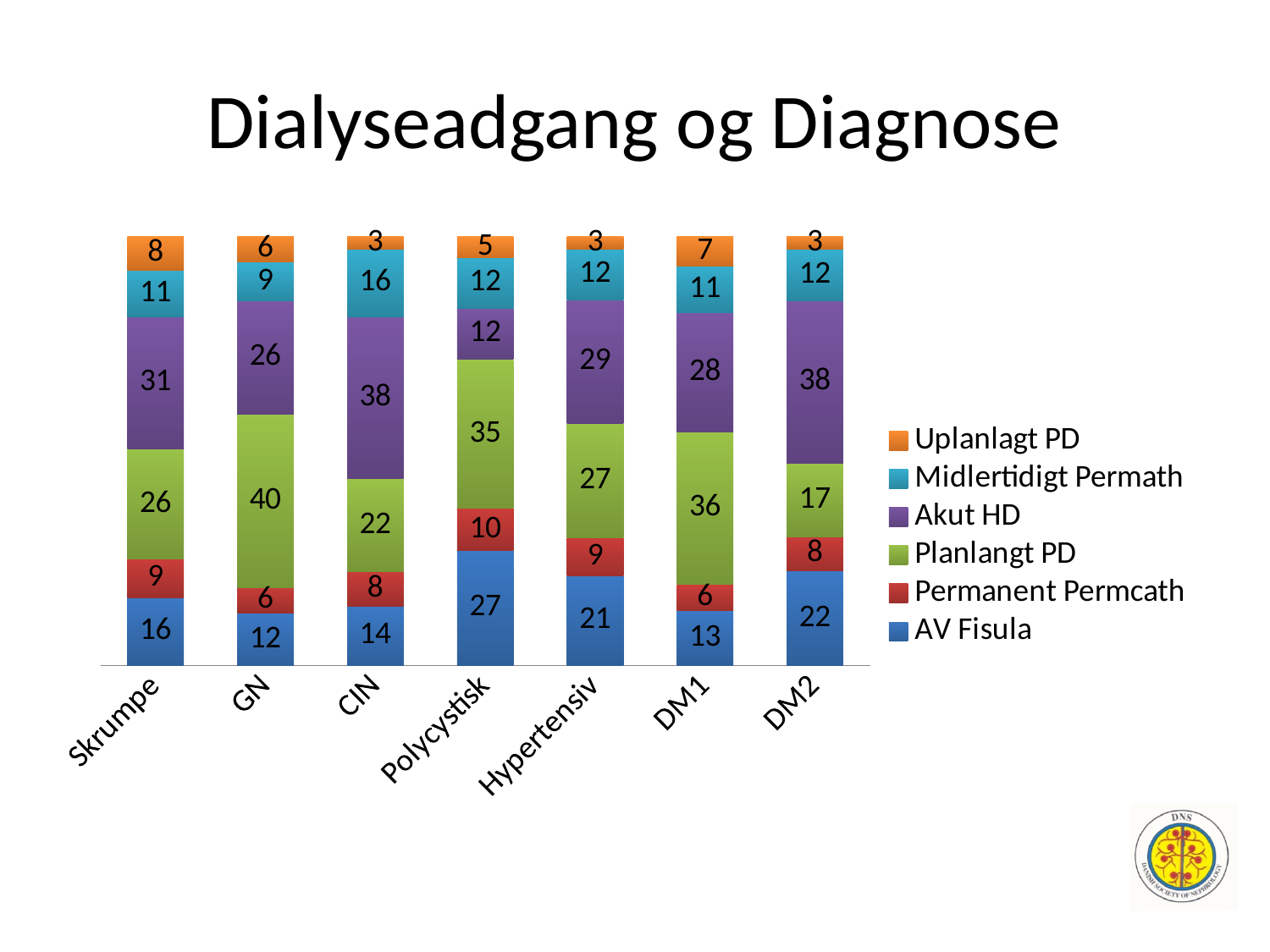
Which diagnosis has the lowest AV Fisula value? GN Which is larger, the Permanent Permcath value for Polycystisk or for DM1? Polycystisk What is the difference between the Akut HD values for CIN and Polycystisk? 26 What kind of chart is shown on the slide? Stacked bar chart What is the Akut HD value for DM2? 38 How many series does the legend list? 6 What is the Uplanlagt PD value for Skrumpe? 8 What is the AV Fisula value for Polycystisk? 27 What is the Midlertidigt Permath value for CIN? 16 How many diagnosis categories are shown on the x axis? 7 Which diagnosis has the highest Planlangt PD value? GN What is the Planlangt PD value for GN? 40